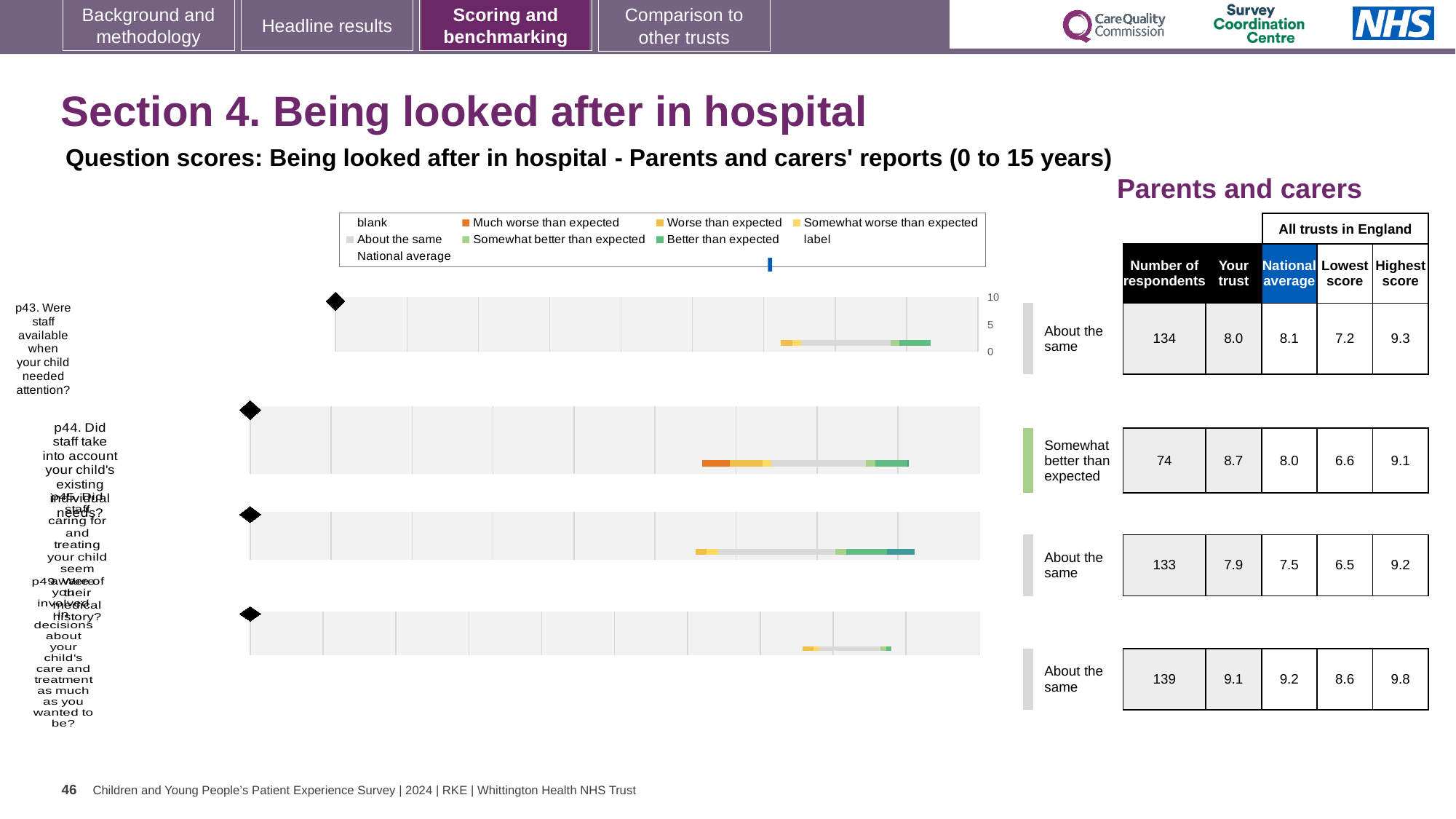
What benchmark category is shown for p44 (Did staff take into account your child's existing individual needs?)? Somewhat better than expected How many survey questions (p43, p44, p45, p49) have a benchmark bar chart on this slide? 4 What is the highest score among all trusts in England for p49? 9.8 Which question has the highest 'Your trust' score on this slide? p49 How many respondents answered p49 (Were you involved in decisions about your child's care and treatment as much as you wanted to be?)? 139 What kind of chart is used to show the question scores on this slide? Bar chart What is the national average score for p45 (Did staff caring for and treating your child seem aware of their medical history?)? 7.5 What is the 'Your trust' score for p43 (Were staff available when your child needed attention?)? 8.0 In the chart legend, which colour represents 'Much worse than expected'? Orange Which question has the lowest number of respondents? p44 For p45, which is larger: the 'Your trust' score or the national average? Your trust For p44, what is the difference between the 'Your trust' score and the national average? 0.7